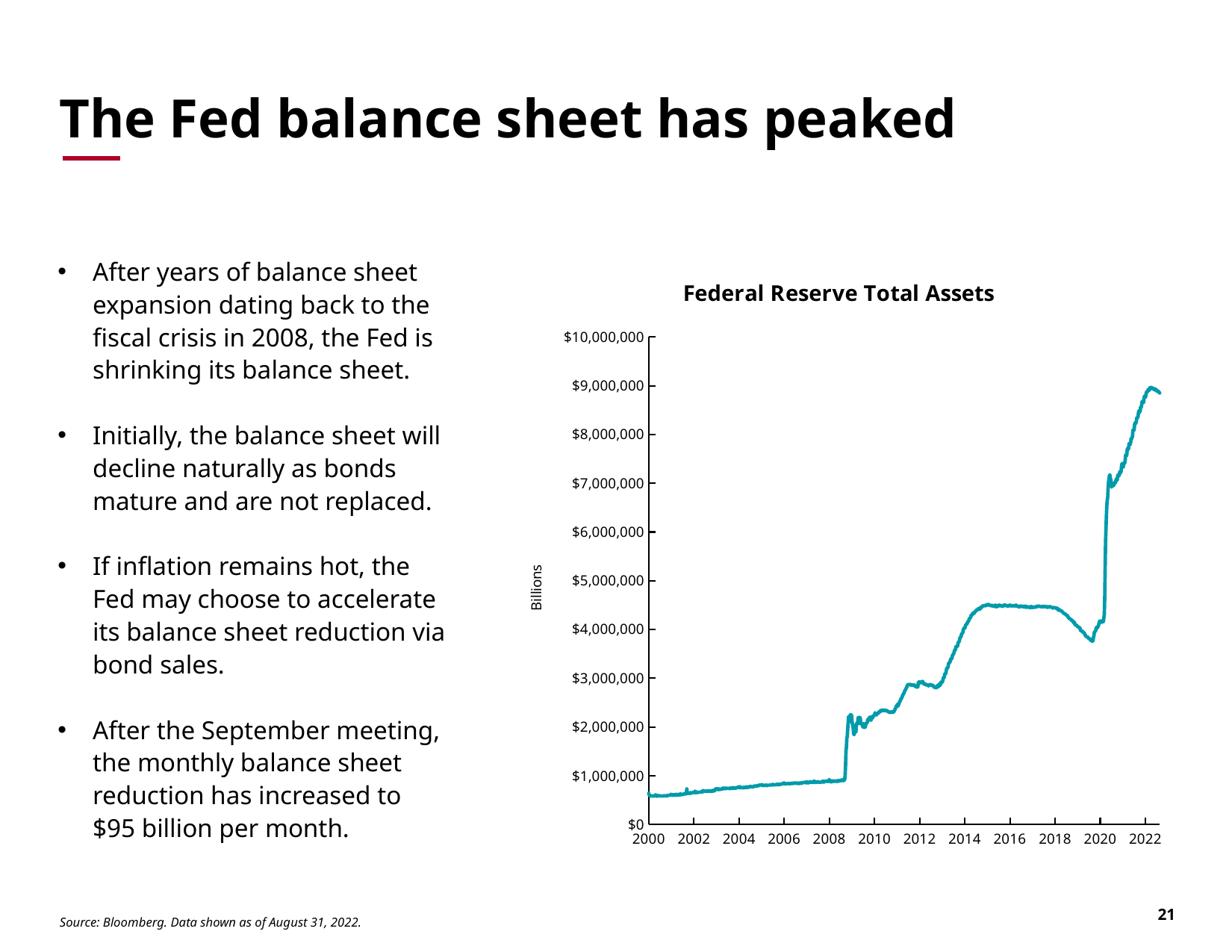
Overall, do Federal Reserve Total Assets rise or fall from 2000 to 2022? rise Is the value for Federal Reserve Total Assets in 2016 greater or less than $4,000,000? greater Which is larger, Federal Reserve Total Assets in 2016 or in 2019? 2016 Is the value for Federal Reserve Total Assets in 2010 greater or less than $2,000,000? greater What is the title of the chart? Federal Reserve Total Assets Which is larger, Federal Reserve Total Assets in 2010 or in 2022? 2022 What is the label on the vertical axis of the chart? Billions Is the value for Federal Reserve Total Assets in 2000 greater or less than $1,000,000? less Do Federal Reserve Total Assets rise or fall between 2018 and 2019? fall What type of chart is shown on the slide? line chart